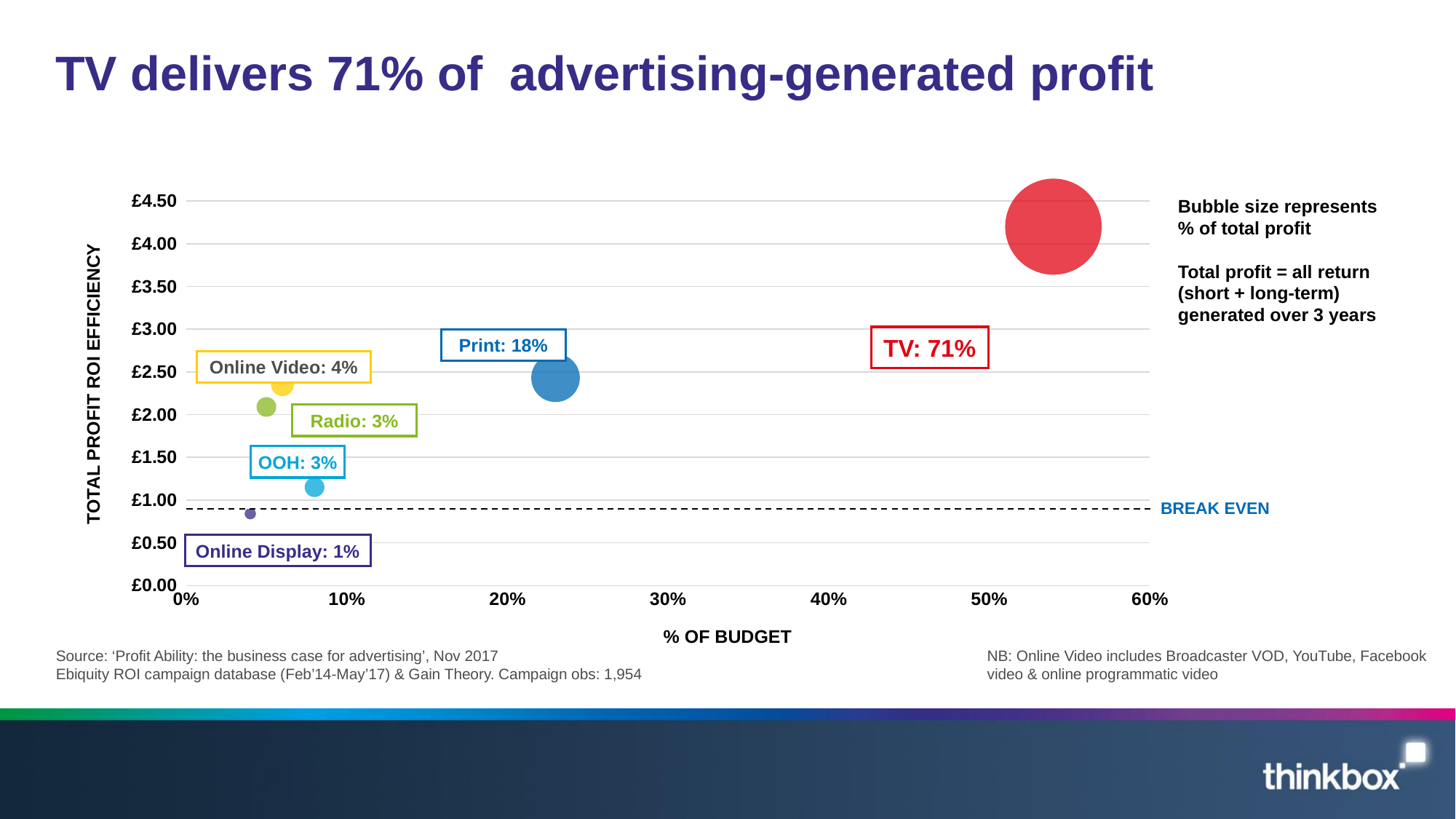
Is the total profit ROI efficiency for TV greater or less than £4.00? greater What is the difference in share of total profit between TV and Print? 53% How many media bubbles are plotted on the chart? 6 What kind of chart is shown on the slide? Bubble chart What percentage of total profit does the TV bubble represent? 71% What percentage of total profit does Online Video represent? 4% What percentage of total profit does the Print bubble represent? 18% Is the total profit ROI efficiency for Online Display greater or less than £1.00? less Which medium has the largest bubble, i.e. the largest share of total profit? TV What percentage of total profit does Online Display represent? 1% Is the % of budget for TV greater or less than 50%? greater Which medium has the smallest share of total profit? Online Display